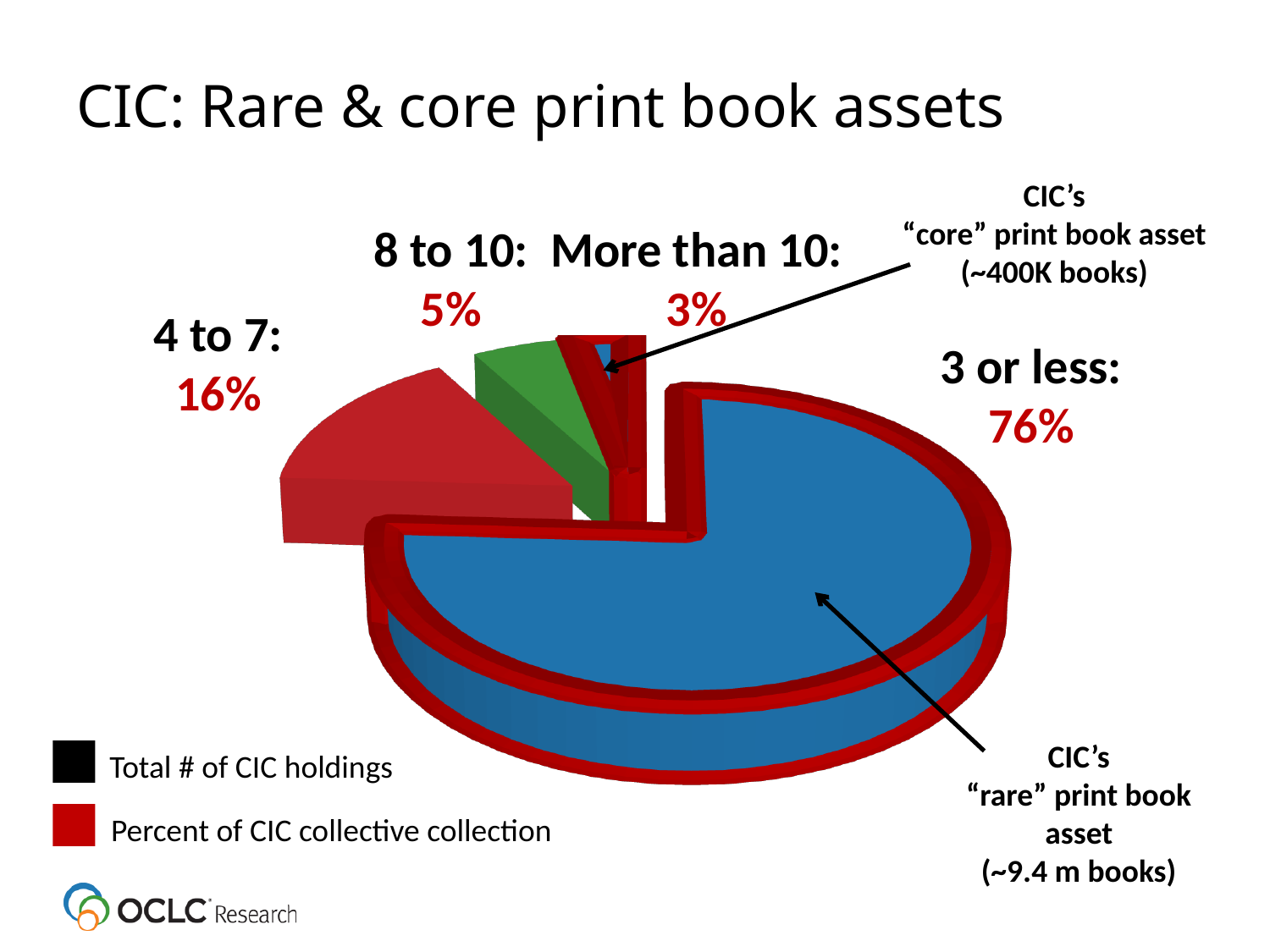
What is the difference in percentage points between the '3 or less' slice and the '4 to 7' slice? 60 What percent of the CIC collective collection is held by 4 to 7 CIC holdings? 16% Which holdings category has the largest share of the pie? 3 or less What percent of the CIC collective collection is held by 8 to 10 CIC holdings? 5% What percent of the CIC collective collection is held by 3 or less CIC holdings? 76% Which slice is larger: '8 to 10' or 'More than 10'? 8 to 10 How many slices does the pie chart have? 4 What kind of chart is shown on the slide? pie chart Which slice is labelled as CIC's "core" print book asset (~400K books)? More than 10 Approximately how many books make up CIC's "rare" print book asset, according to the annotation? ~9.4 m books Which holdings category has the smallest share of the pie? More than 10 What percent of the CIC collective collection is held by more than 10 CIC holdings? 3%